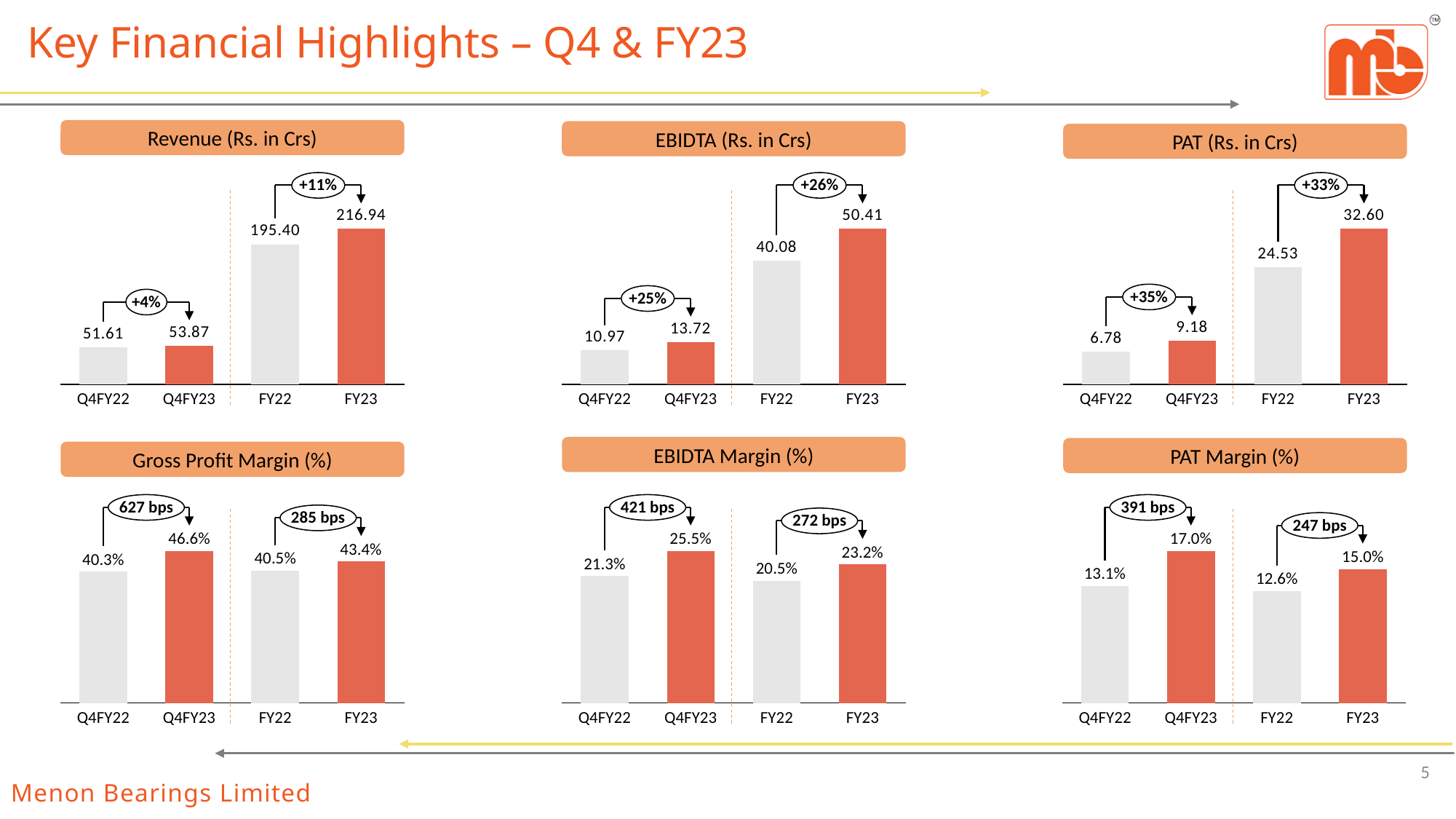
In the EBIDTA (Rs. in Crs) chart, is the value for FY23 larger than the value for FY22? Yes, FY23 In the Gross Profit Margin (%) chart, what is the value for Q4FY23? 46.6% In the EBIDTA (Rs. in Crs) chart, what is the value for Q4FY22? 10.97 In the Revenue (Rs. in Crs) chart, what is the value for FY23? 216.94 In the Revenue (Rs. in Crs) chart, what percentage growth is annotated between FY22 and FY23? +11% In the PAT (Rs. in Crs) chart, what is the difference between FY23 and FY22? 8.07 In the EBIDTA Margin (%) chart, what is the value for FY22? 20.5% How many categories are shown on the x axis of the Gross Profit Margin (%) chart? 4 In the PAT Margin (%) chart, which category has the lowest value? FY22 In the PAT (Rs. in Crs) chart, what is the value for FY22? 24.53 What kind of chart is the PAT Margin (%) chart? Bar chart In the Revenue (Rs. in Crs) chart, which category has the highest value? FY23